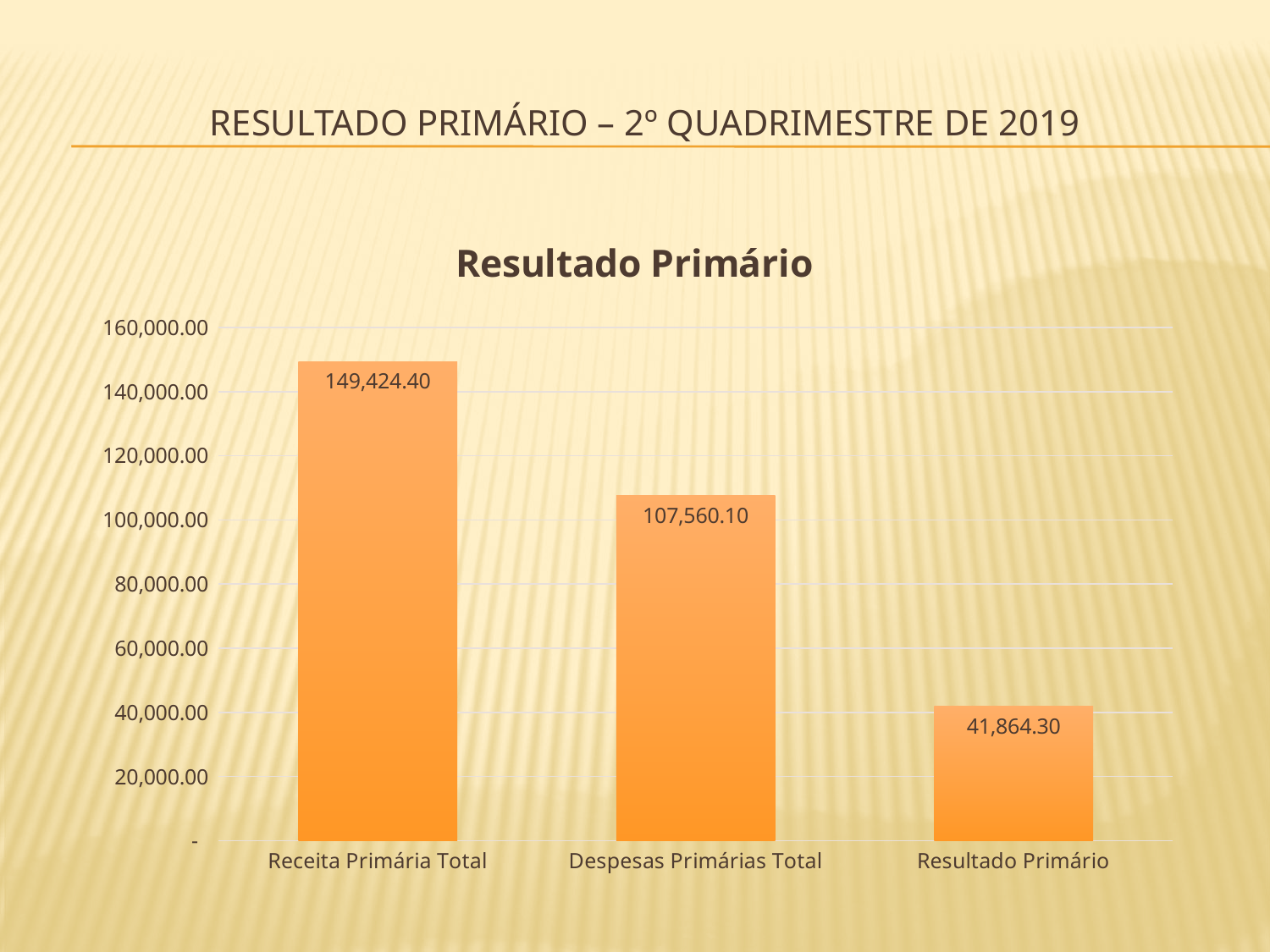
What kind of chart is shown on the slide? bar chart What is the difference between Receita Primária Total and Despesas Primárias Total? 41,864.30 What is the value for Resultado Primário? 41,864.30 What is the difference between Despesas Primárias Total and Resultado Primário? 65,695.80 Is the value for Despesas Primárias Total greater or less than 100,000.00? greater Which category has the highest value? Receita Primária Total Which category has the lowest value? Resultado Primário Which is larger, Despesas Primárias Total or Resultado Primário? Despesas Primárias Total What is the value for Despesas Primárias Total? 107,560.10 What is the title of the chart? Resultado Primário How many categories are shown in the chart? 3 What is the value for Receita Primária Total? 149,424.40